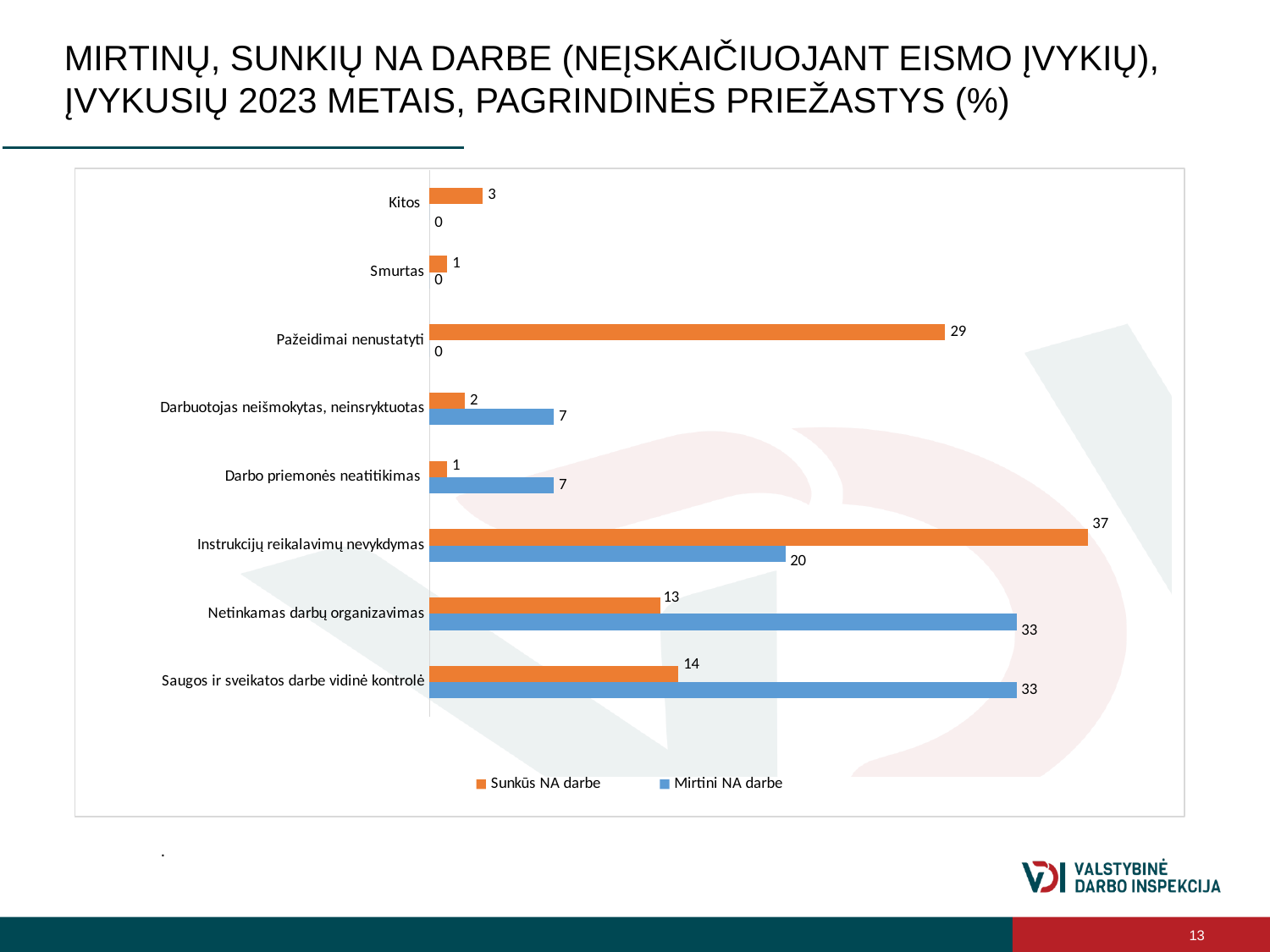
How many series does the legend list? 2 Which category has the lowest value for Sunkūs NA darbe? Smurtas and Darbo priemonės neatitikimas (both 1) What is the difference between the Sunkūs NA darbe and Mirtini NA darbe values for Instrukcijų reikalavimų nevykdymas? 17 Which category has the highest value for Sunkūs NA darbe? Instrukcijų reikalavimų nevykdymas What is the value for Sunkūs NA darbe in the category Instrukcijų reikalavimų nevykdymas? 37 What is the value for Sunkūs NA darbe in the category Pažeidimai nenustatyti? 29 What type of chart is shown on the slide? bar chart Which colour represents the Mirtini NA darbe series in the legend? blue How many categories are shown on the chart? 8 For Saugos ir sveikatos darbe vidinė kontrolė, which series has the larger value, Sunkūs NA darbe or Mirtini NA darbe? Mirtini NA darbe What is the value for Mirtini NA darbe in the category Darbo priemonės neatitikimas? 7 What is the value for Mirtini NA darbe in the category Netinkamas darbų organizavimas? 33